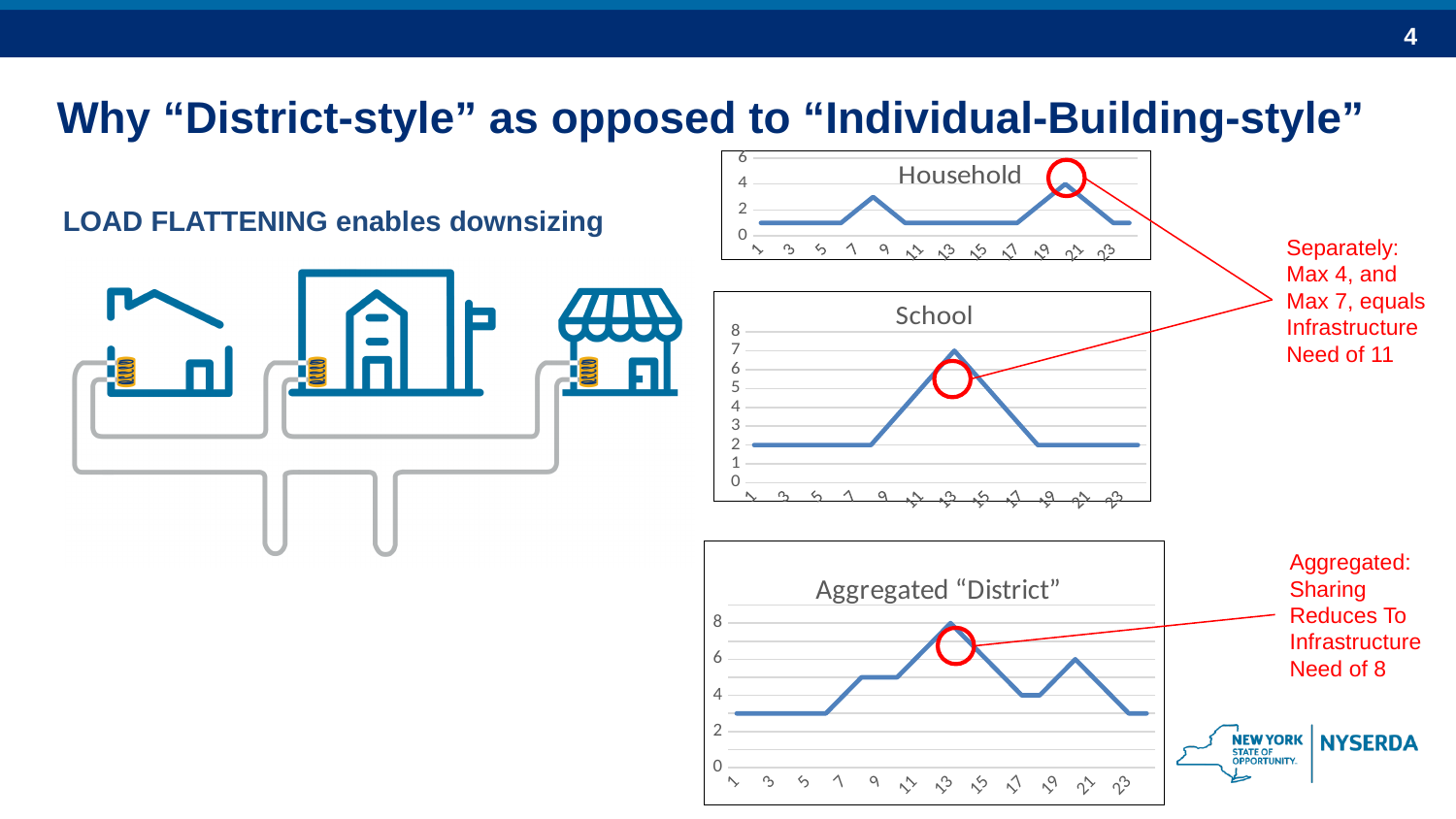
In the School chart, what is the value at x = 13? 7 In the School chart, what is the value at x = 1? 2 In the Household chart, is the value at x = 1 greater or less than 2? less What kind of chart is the Household chart? line chart In the Aggregated "District" chart, what is the highest value reached by the line? 8 Which chart has the higher peak value, School or Household? School In the Household chart, what is the highest value reached by the line? 4 What is the difference between the peak value in the School chart and the peak value in the Household chart? 3 In the School chart, what is the highest value reached by the line? 7 How many charts are shown on the slide? 3